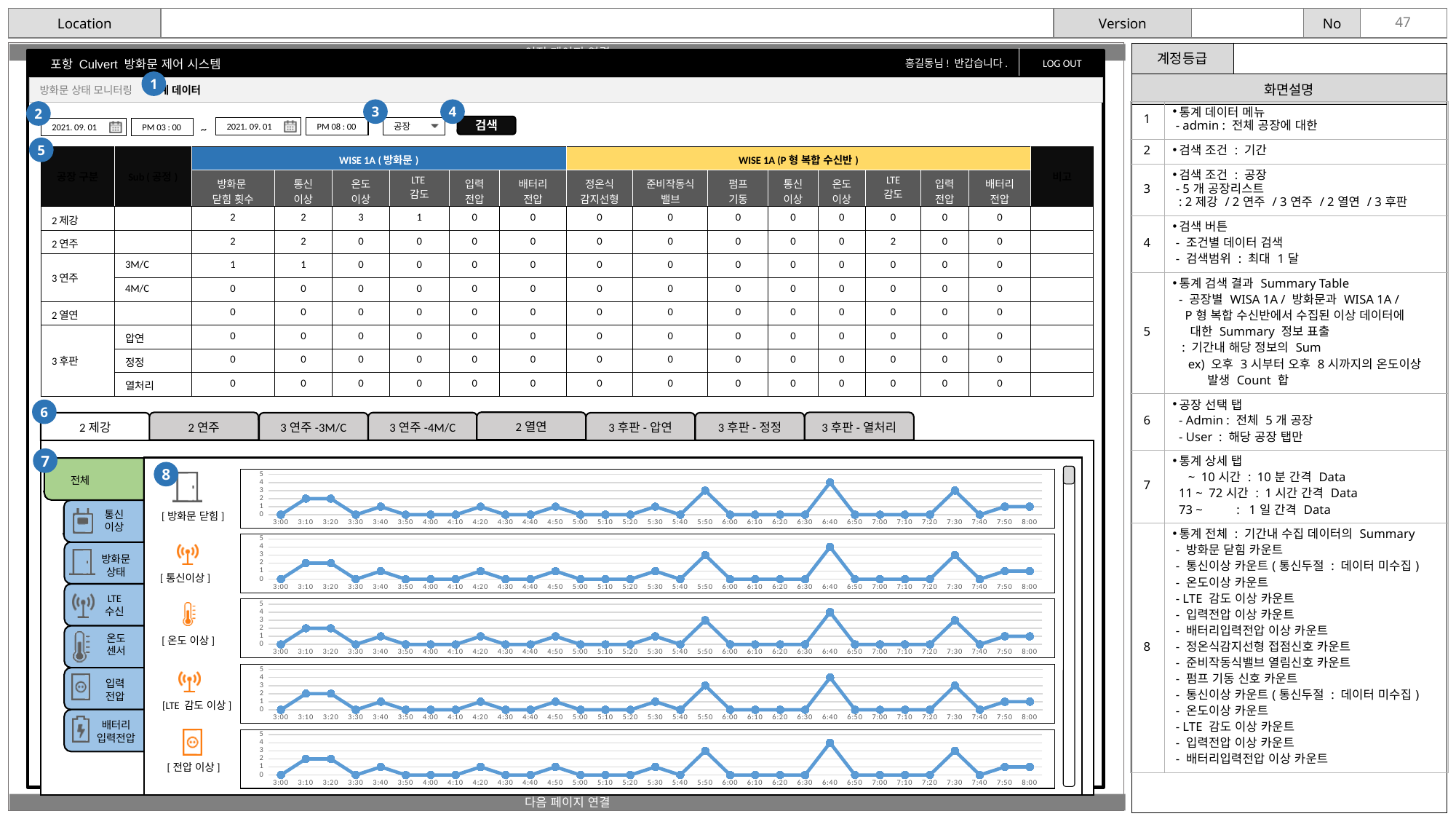
In the [방화문 닫힘] chart, is the value at 6:40 greater or less than 2? greater In the [방화문 닫힘] chart, which is larger, the value at 6:40 or the value at 3:10? 6:40 What kind of chart is the [방화문 닫힘] chart at the bottom of the slide? line chart What is the highest tick value shown on the y axis of the [LTE 감도 이상] chart? 5 In the [전압 이상] chart, at which time does the line reach its highest value? 6:40 In the [온도 이상] chart, which is larger, the value at 5:50 or the value at 5:40? 5:50 How many time points are plotted along the x axis of the [방화문 닫힘] chart? 31 In the [통신이상] chart, is the value at 3:00 greater or less than 1? less How many line charts are shown in the lower section of the slide? 5 In the [방화문 닫힘] chart, at which time does the line reach its highest value? 6:40 What is the first time label on the x axis of the [방화문 닫힘] chart? 3:00